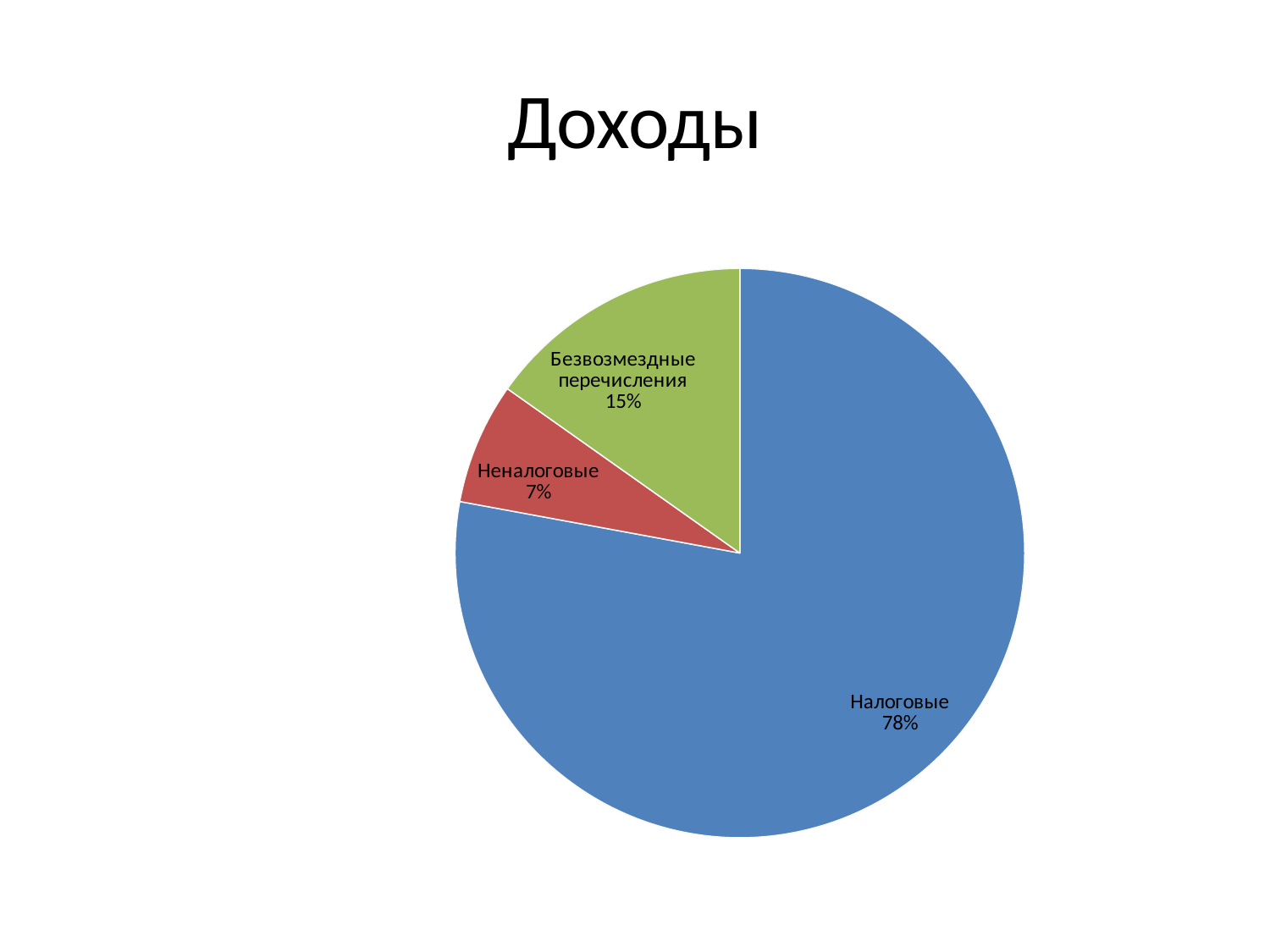
How many slices does the pie chart have? 3 What share of the pie does Неналоговые take? 7% What is the title of the chart? Доходы What colour is the Налоговые slice? blue What is the difference in percentage points between Налоговые and Безвозмездные перечисления? 63 Which is larger, Неналоговые or Безвозмездные перечисления? Безвозмездные перечисления What is the difference in percentage points between Безвозмездные перечисления and Неналоговые? 8 Which category has the smallest slice? Неналоговые What share of the pie does Безвозмездные перечисления take? 15% Which category has the largest slice? Налоговые What share of the pie does Налоговые take? 78% What kind of chart is shown on the slide? pie chart